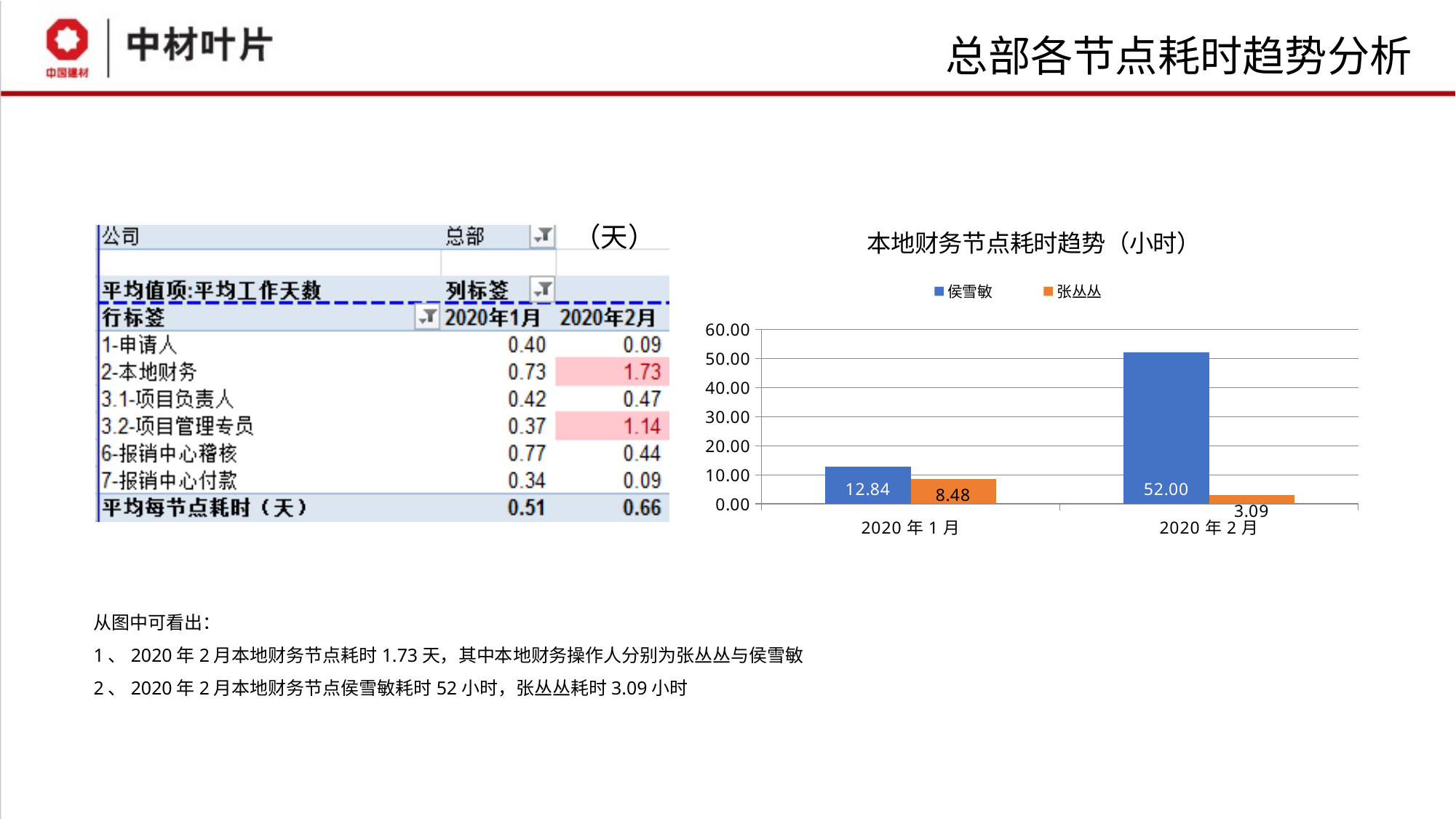
What is the title of the chart? 本地财务节点耗时趋势（小时） What is the value for 侯雪敏 in 2020年1月? 12.84 What is the value for 侯雪敏 in 2020年2月? 52.00 How many categories are shown on the x axis of the chart? 2 In which month is the value for 侯雪敏 highest? 2020年2月 In which month is the value for 张丛丛 lowest? 2020年2月 What is the value for 张丛丛 in 2020年2月? 3.09 Does the value for 张丛丛 rise or fall from 2020年1月 to 2020年2月? fall What is the value for 张丛丛 in 2020年1月? 8.48 What is the difference between 侯雪敏 and 张丛丛 in 2020年2月? 48.91 How many series does the chart legend list? 2 What type of chart is shown on the slide? bar chart